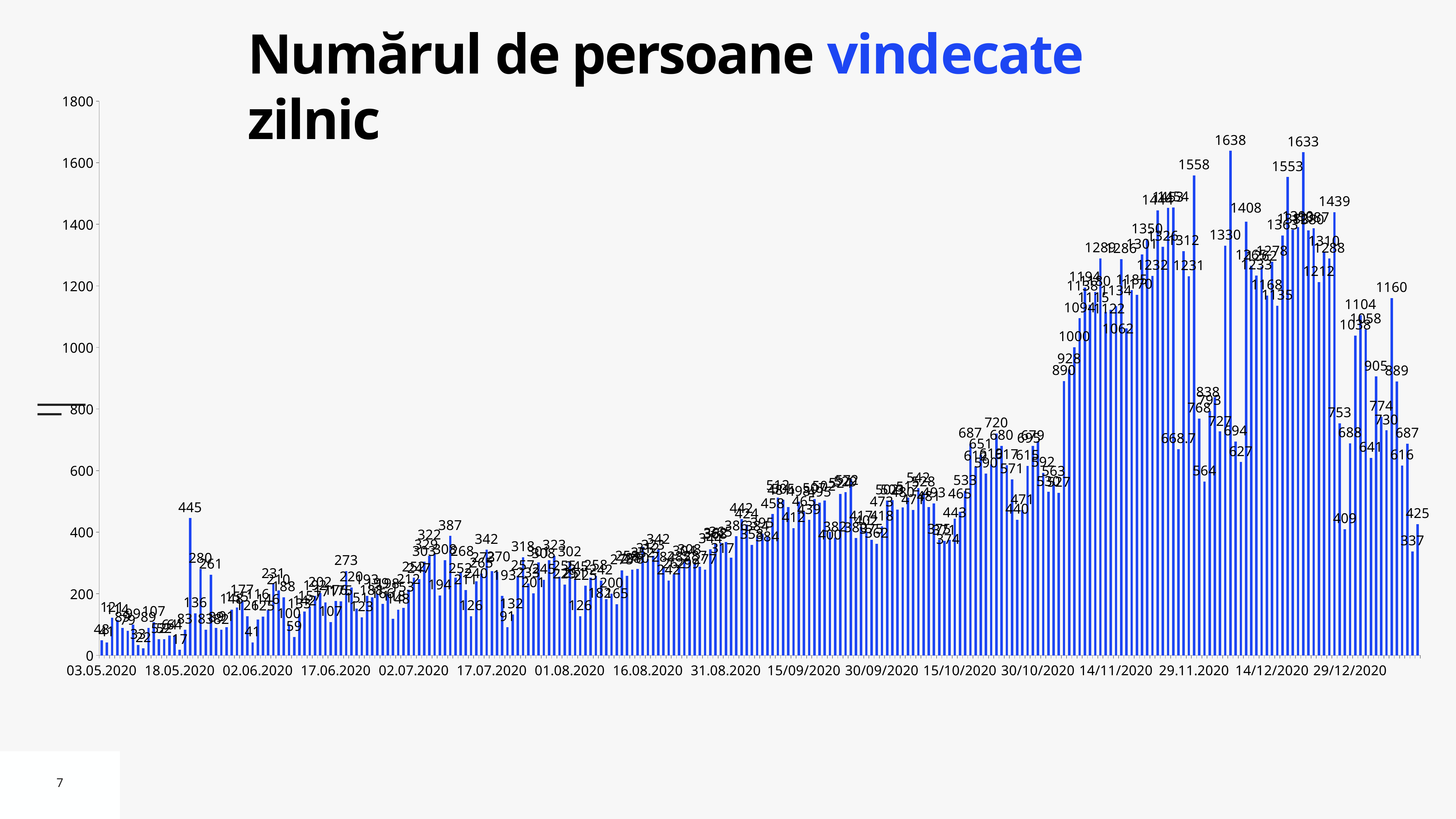
What is the highest daily value shown in the chart? 1638 What kind of chart is shown on the slide? bar chart What is the title of the chart? Numărul de persoane vindecate zilnic Overall, do the daily values rise or fall from May 2020 to December 2020? rise What is the value of the last bar on the right of the chart? 425 What is the highest tick value shown on the vertical axis? 1800 Is the value of the last bar on the right greater or less than 400? greater Which is larger, the peak value 1558 or the peak value 1553? 1558 What is the second highest daily value labelled in the chart? 1633 What is the difference between the two highest labelled values, 1638 and 1633? 5 What is the difference between the labelled values 1439 and 1408? 31 What is the highest value reached in May 2020 (before 02.06.2020)? 445